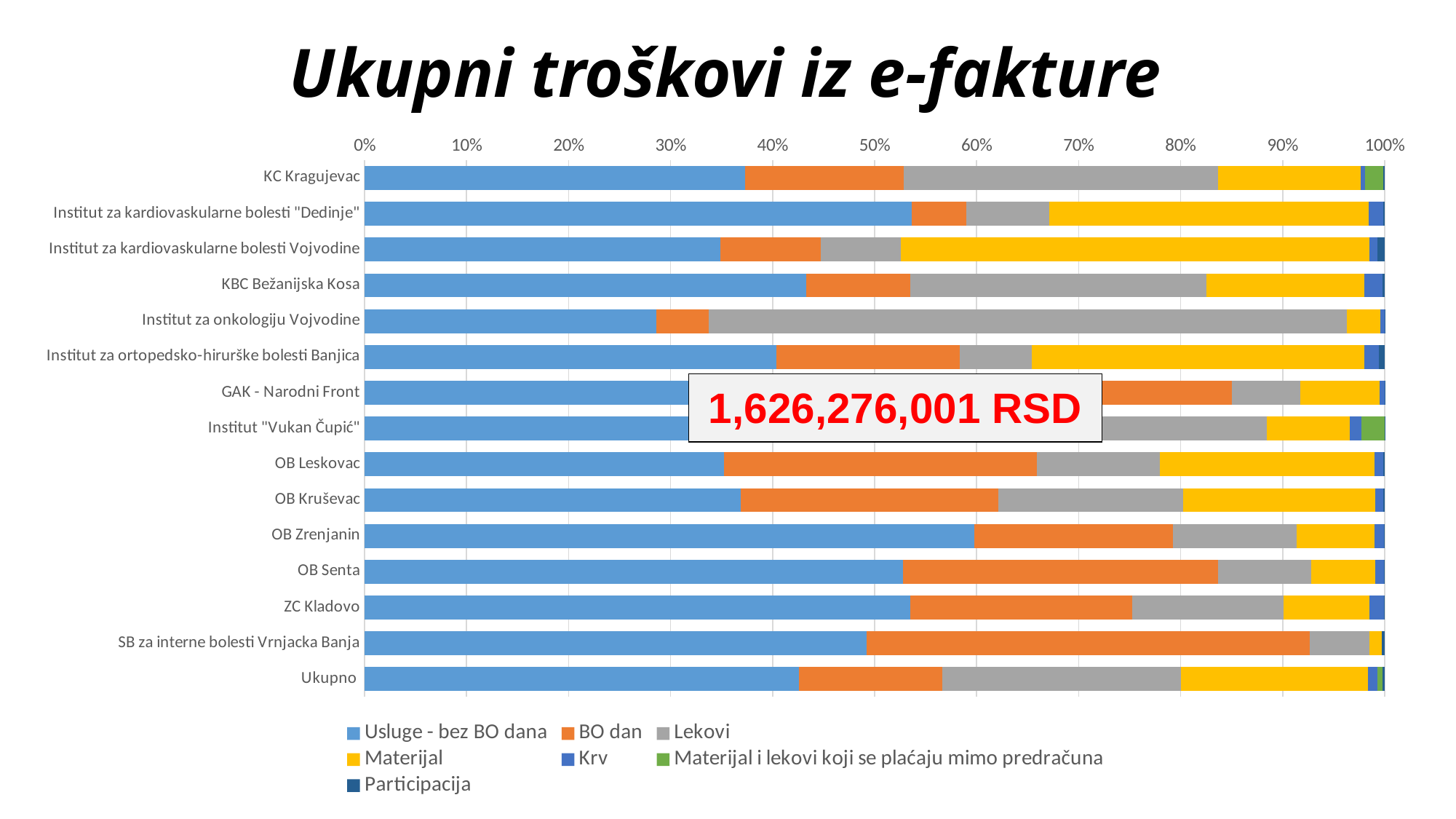
What value is shown in the red text box overlaid on the chart? 1,626,276,001 RSD Is the share of "Usluge - bez BO dana" for KC Kragujevac greater or less than 40%? less How many series does the legend list? 7 Is the share of "Lekovi" for Institut za onkologiju Vojvodine greater or less than 50%? greater Is the share of "Usluge - bez BO dana" for Institut za onkologiju Vojvodine greater or less than 30%? less How many categories (rows) are plotted on the chart? 15 What is the title of the chart? Ukupni troškovi iz e-fakture Which category has the largest share of "Lekovi"? Institut za onkologiju Vojvodine What kind of chart is shown on the slide? Stacked bar chart Which has a larger share of "BO dan": SB za interne bolesti Vrnjacka Banja or KC Kragujevac? SB za interne bolesti Vrnjacka Banja Which category has the largest share of "Materijal"? Institut za kardiovaskularne bolesti Vojvodine